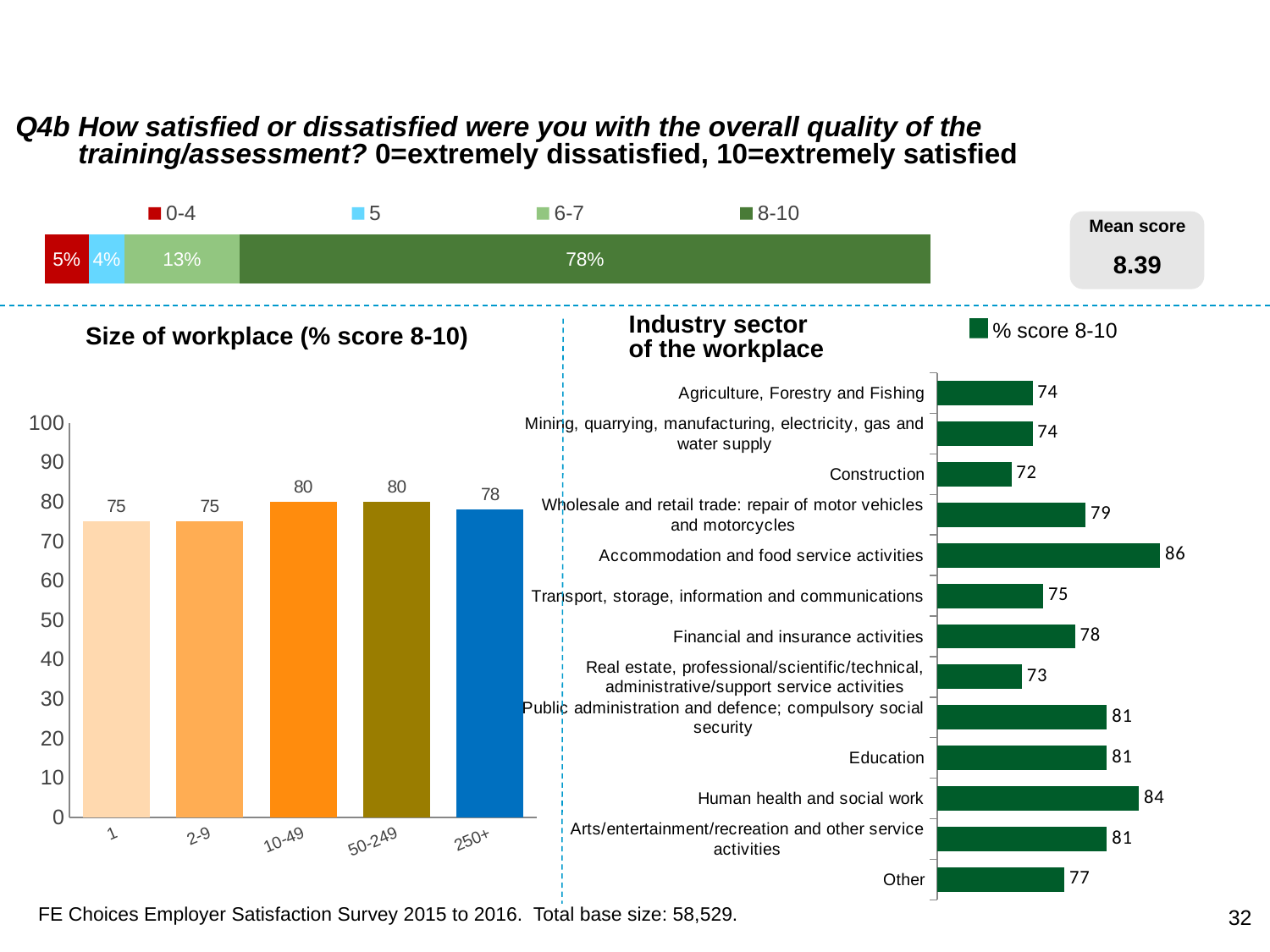
In the 'Industry sector of the workplace' chart, which sector has the highest % score 8-10? Accommodation and food service activities How many series does the legend of the stacked bar at the top of the slide list? 4 In the 'Industry sector of the workplace' chart, which is larger: the value for Education or the value for Financial and insurance activities? Education In the 'Industry sector of the workplace' chart, which sector has the lowest % score 8-10? Construction In the 'Size of workplace (% score 8-10)' chart, what is the value for the 250+ category? 78 In the 'Industry sector of the workplace' chart, what is the value for Human health and social work? 84 In the 'Industry sector of the workplace' chart, how many industry sectors are listed? 13 In the 'Size of workplace (% score 8-10)' chart, what is the difference between the values for 10-49 and 1? 5 In the 'Industry sector of the workplace' chart, what is the value for Other? 77 In the 'Size of workplace (% score 8-10)' chart, how many workplace size categories are shown? 5 What kind of chart is the 'Size of workplace (% score 8-10)' chart? bar chart In the stacked bar at the top of the slide, what percentage scored 8-10? 78%